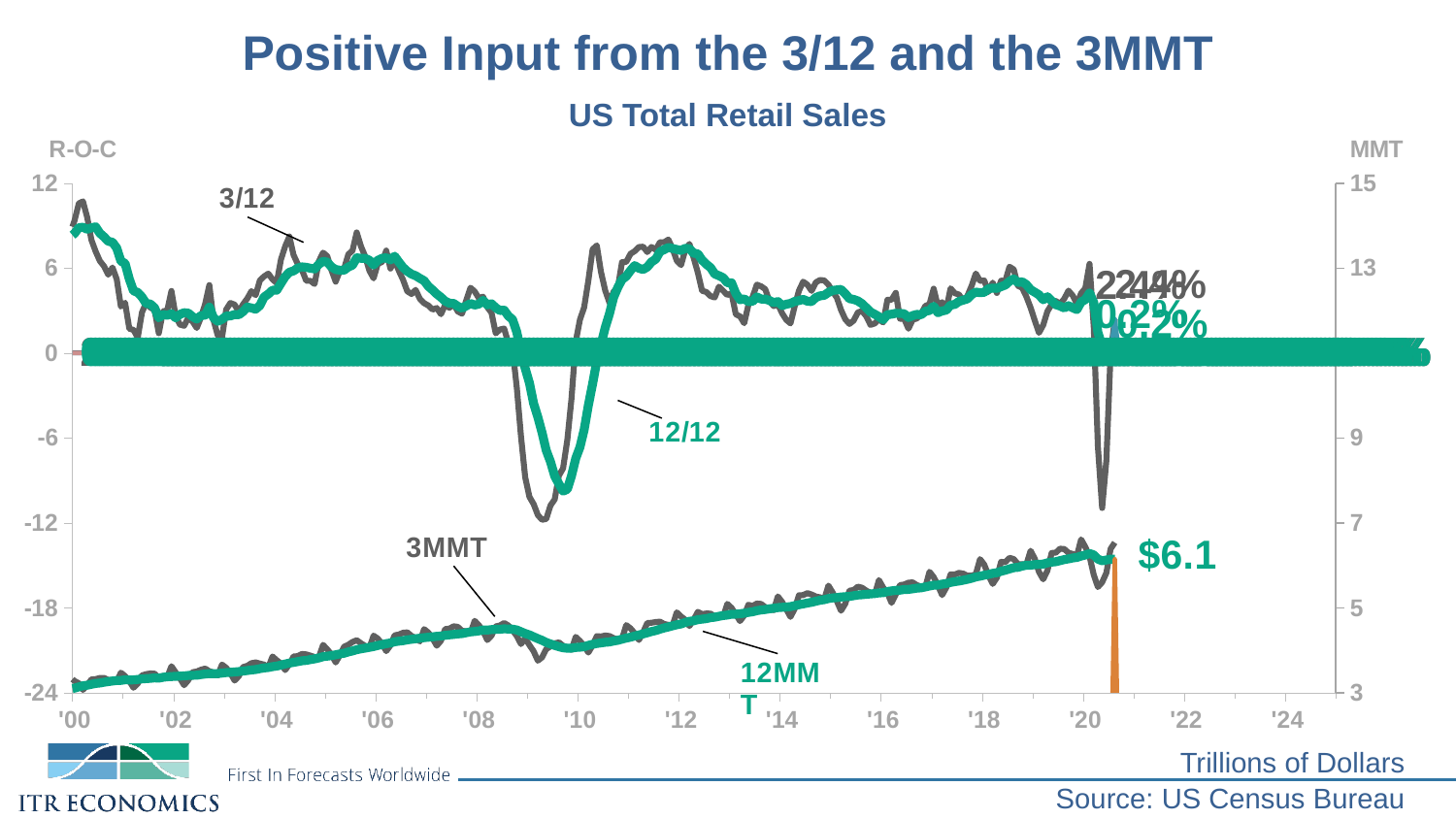
Is the 12MMT value larger at '20 or at '00? '20 Does the 12MMT line rise or fall overall from '00 to '20? rises Is the lowest value of the 12/12 line (around 2009-2010) greater or less than -6 on the R-O-C axis? less What is the source cited for the chart data? US Census Bureau Is the 3/12 line's dip around 2020 greater or less than -6 on the R-O-C axis? less What kind of chart is shown on the slide? line chart How many data series are labeled on the chart? 4 What is the title of the chart? US Total Retail Sales Does the 12/12 line reach its lowest point around 2009-2010 or around 2020? around 2009-2010 Is the 12MMT value at '00 greater or less than 5 on the MMT axis? less What is the latest labeled value of the 12MMT line? $6.1 What is the maximum value shown on the left R-O-C axis? 12